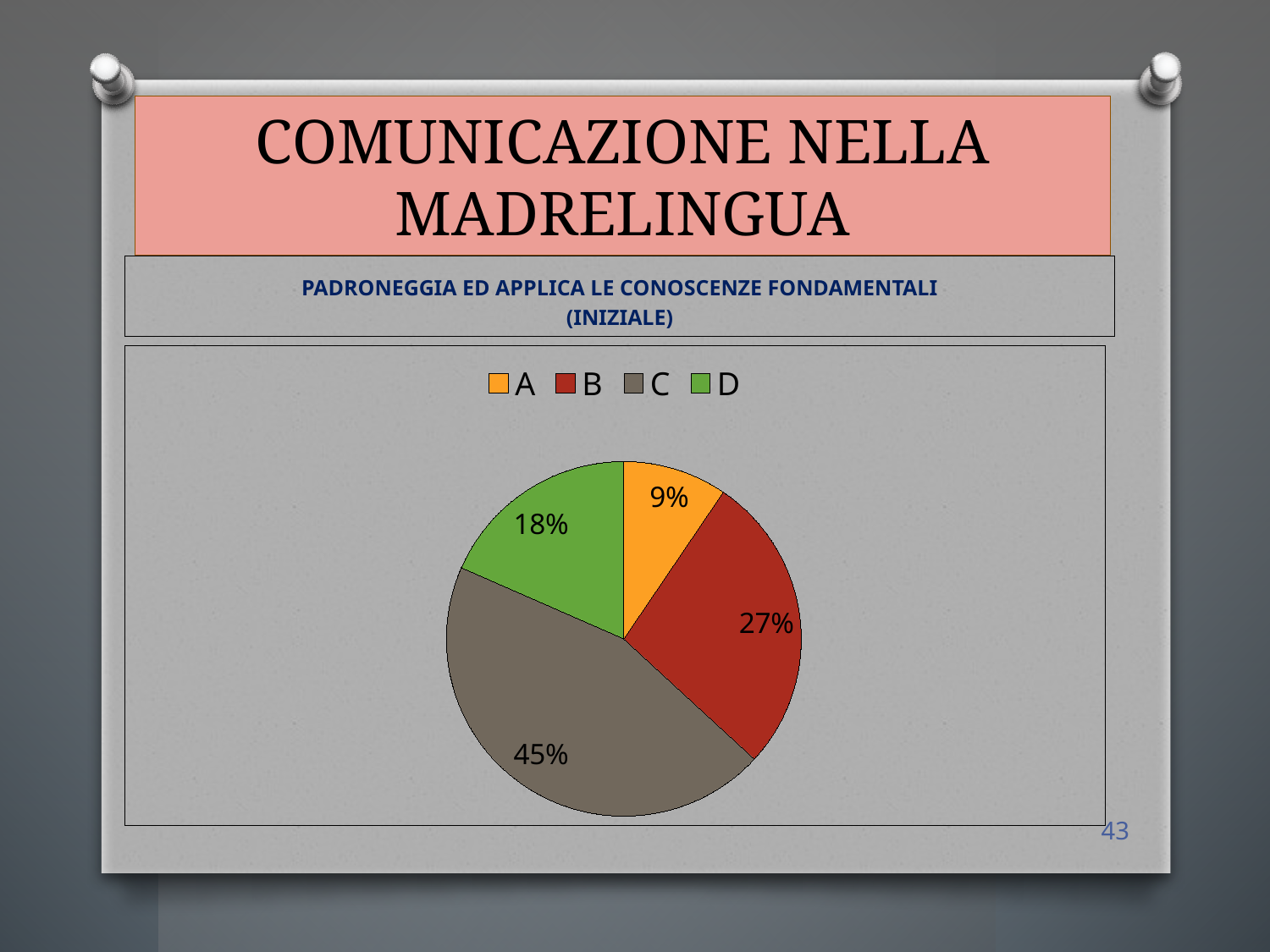
How many categories does the pie chart show? 4 What is the difference between the values for C and B? 18% What is the value for category C? 45% What colour is the slice for category C? grey What kind of chart is shown on the slide? pie chart What is the value for category B? 27% Which category has the largest slice of the pie? C What is the difference between the values for D and A? 9% What is the value for category D? 18% Which is larger, the value for D or the value for B? B What is the value for category A? 9% Which category has the smallest slice of the pie? A